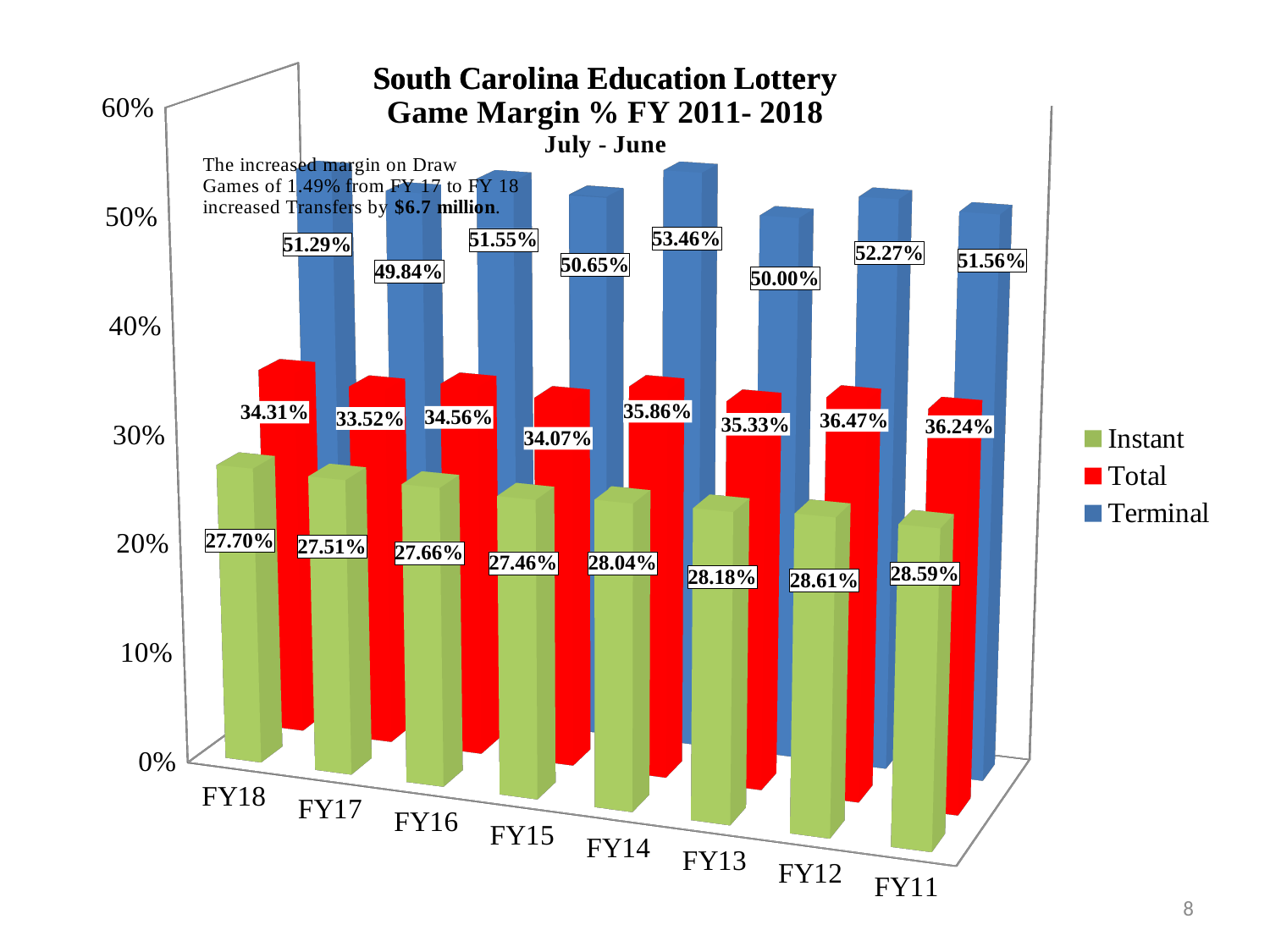
How many fiscal years are shown on the x axis? 8 What kind of chart is shown on the slide? bar chart Which is larger, the Total margin for FY12 or for FY18? FY12 What is the Total margin for FY17? 33.52% Which fiscal year has the lowest Terminal margin? FY17 What is the Instant margin for FY18? 27.70% What is the Terminal margin for FY14? 53.46% Is the Terminal margin for FY17 greater or less than 50%? less Which fiscal year has the highest Terminal margin? FY14 How many series does the legend list? 3 Which fiscal year has the highest Total margin? FY12 What is the difference between the Terminal margin in FY14 and in FY17? 3.62%